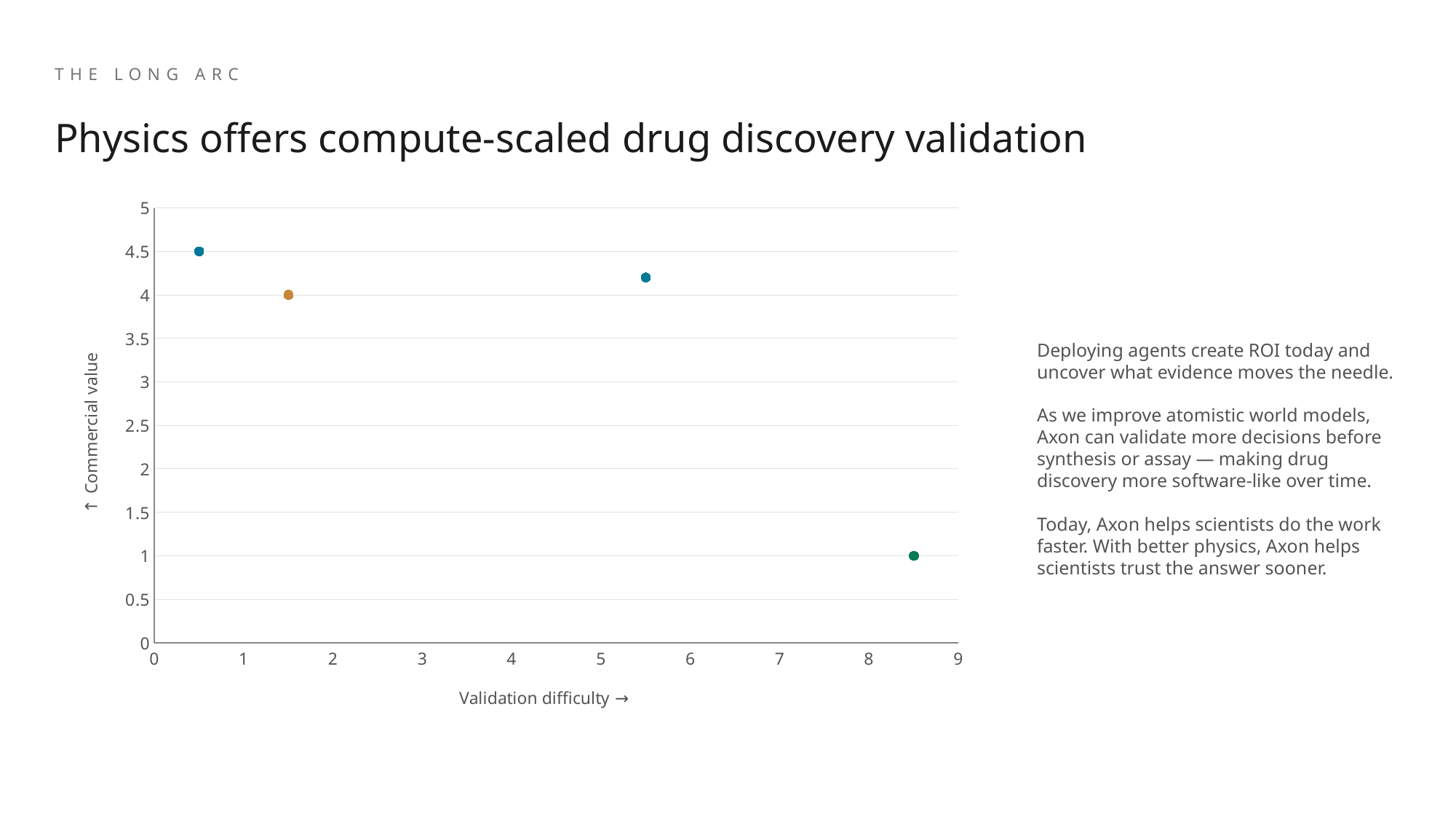
Is the commercial value of the rightmost point greater or less than 2? less What is the difference in commercial value between the leftmost point and the rightmost point? 3.5 What is the commercial value of the rightmost point on the chart? 1 Is the commercial value of the point near validation difficulty 5.5 greater or less than 4? greater Overall, does commercial value rise or fall as validation difficulty increases along the x axis? fall Which point has the lowest commercial value: the leftmost point or the rightmost point? the rightmost point How many data points are plotted on the chart? 4 What kind of chart is shown on the slide? scatter chart Which has the larger commercial value: the leftmost point or the rightmost point? the leftmost point What is the commercial value of the leftmost point on the chart? 4.5 What is the label of the x axis? Validation difficulty → What is the commercial value of the orange point on the chart? 4